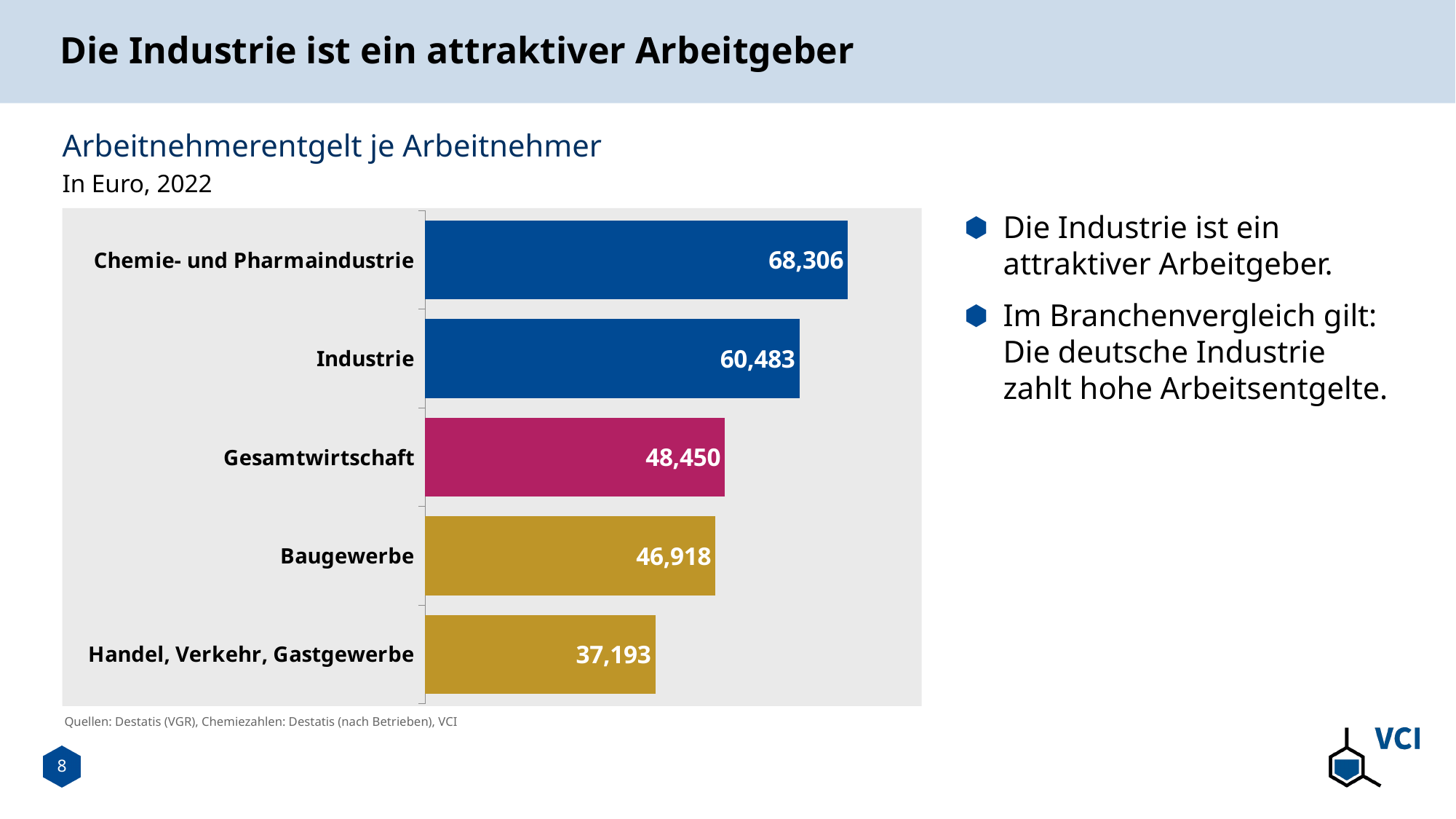
What is the value for Baugewerbe? 46,918 Which category has the lowest value? Handel, Verkehr, Gastgewerbe What is the value for Handel, Verkehr, Gastgewerbe? 37,193 What is the difference between the values for Gesamtwirtschaft and Handel, Verkehr, Gastgewerbe? 11,257 What is the value for Chemie- und Pharmaindustrie? 68,306 Which is larger, the value for Industrie or the value for Gesamtwirtschaft? Industrie Which category has the highest value? Chemie- und Pharmaindustrie What is the difference between the values for Chemie- und Pharmaindustrie and Industrie? 7,823 What kind of chart is shown on the slide? Bar chart What is the value for Industrie? 60,483 How many categories are shown in the chart? 5 What is the value for Gesamtwirtschaft? 48,450